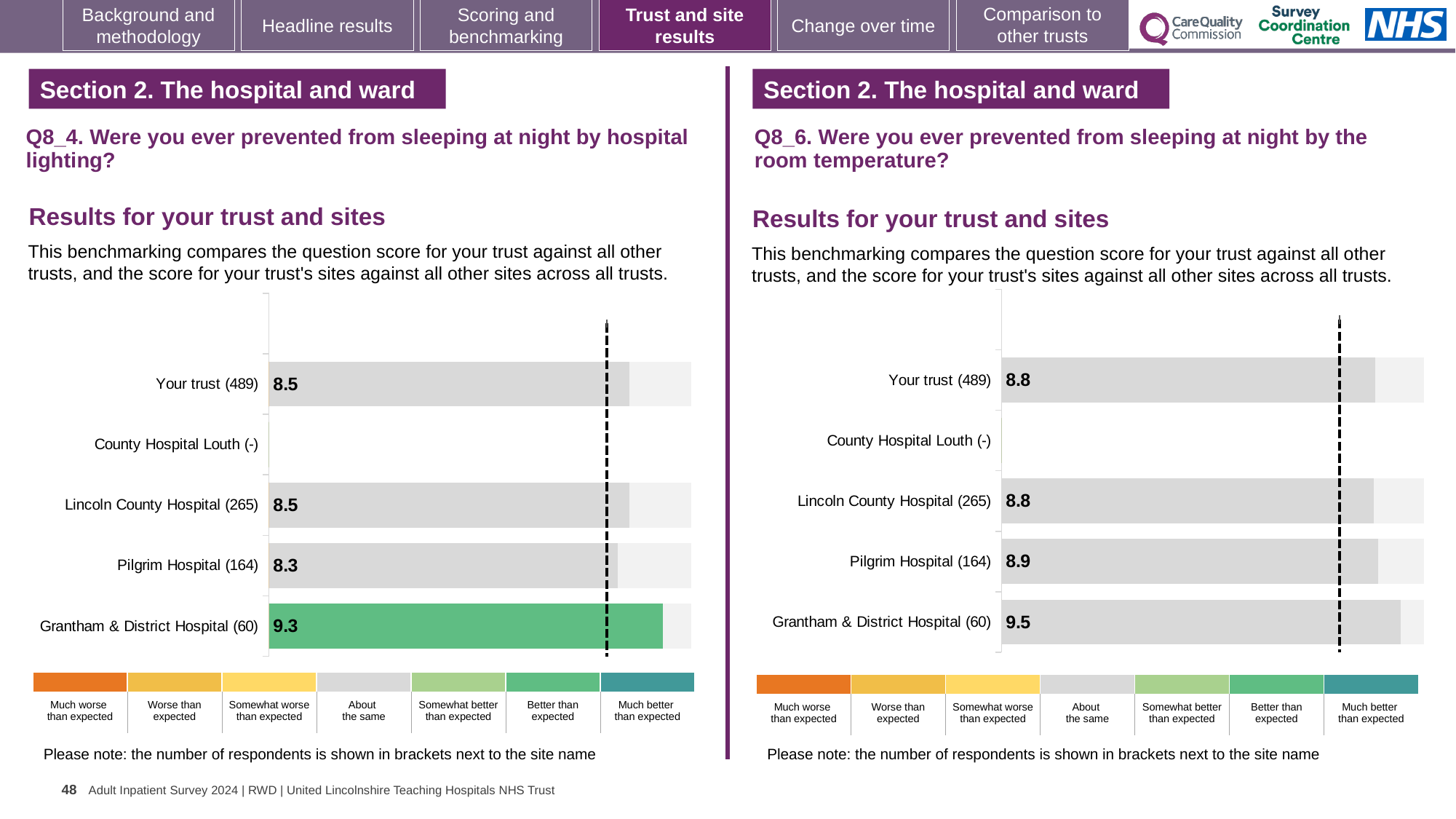
In the Q8_4 chart (hospital lighting), what is the score for Grantham & District Hospital? 9.3 In the Q8_6 chart (room temperature), what is the score for Lincoln County Hospital? 8.8 What kind of chart is used in the Q8_4 chart (hospital lighting)? bar chart In the Q8_4 chart (hospital lighting), what is the score for Your trust? 8.5 In the Q8_6 chart (room temperature), what is the score for Pilgrim Hospital? 8.9 In the Q8_6 chart (room temperature), what is the difference between the scores for Grantham & District Hospital and Your trust? 0.7 In the Q8_4 chart (hospital lighting), what is the difference between the scores for Grantham & District Hospital and Pilgrim Hospital? 1.0 In the Q8_4 chart (hospital lighting), which bar is coloured green? Grantham & District Hospital In the Q8_4 chart (hospital lighting), which site has the lowest score shown? Pilgrim Hospital In the Q8_6 chart (room temperature), is the score for Pilgrim Hospital larger or smaller than the score for Lincoln County Hospital? larger How many respondents are shown in brackets for Lincoln County Hospital in the Q8_4 chart? 265 In the Q8_6 chart (room temperature), which site has the highest score? Grantham & District Hospital